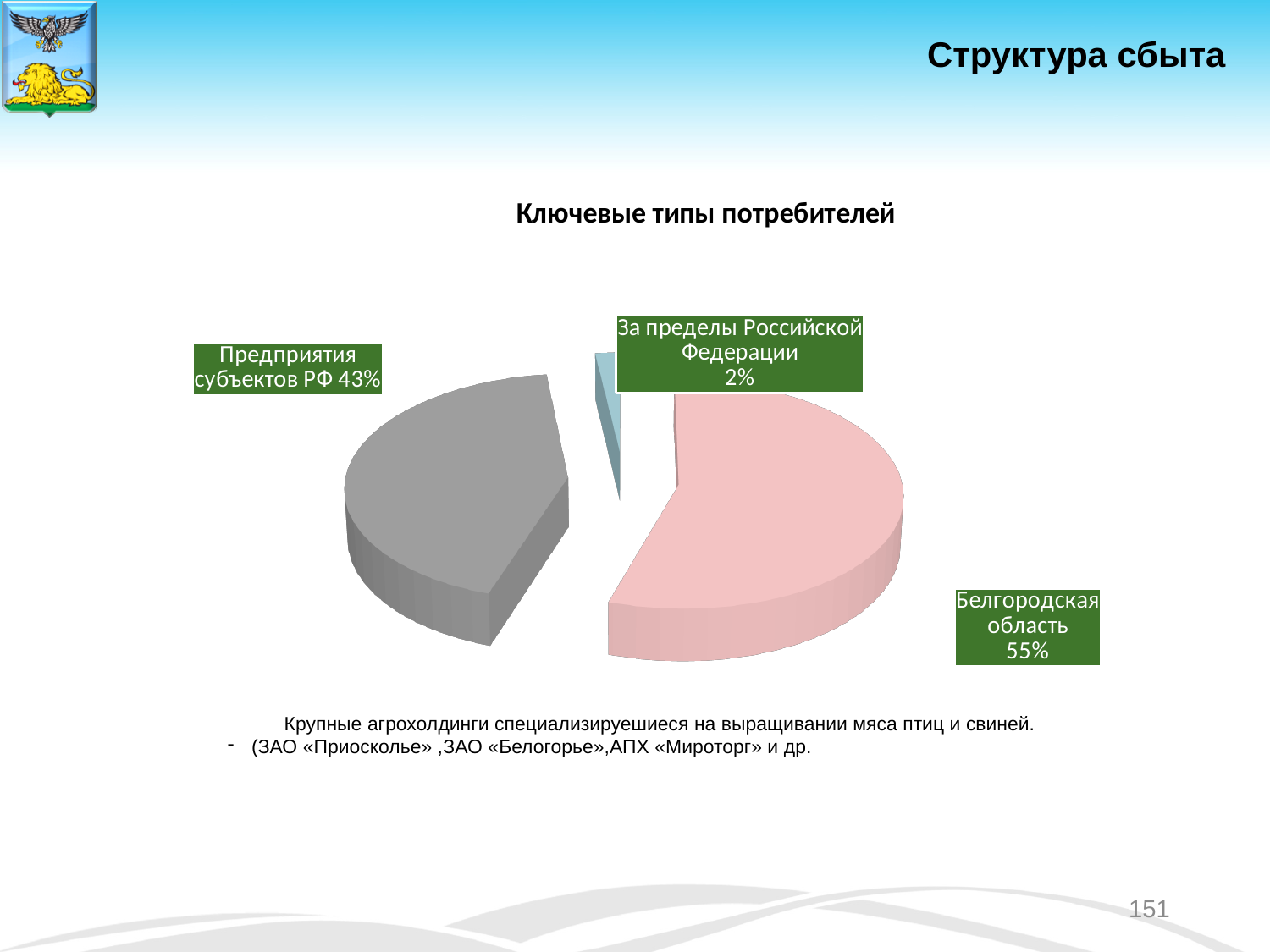
What share of the pie does Белгородская область hold? 55% What share of the pie does За пределы Российской Федерации hold? 2% What is the title of the chart? Ключевые типы потребителей What colour is the slice for Предприятия субъектов РФ? Grey What is the difference between the shares of Белгородская область and Предприятия субъектов РФ? 12% Which category has the largest slice of the pie? Белгородская область What kind of chart is shown on the slide? Pie chart How many categories are shown in the pie chart? 3 What share of the pie does Предприятия субъектов РФ hold? 43% Which is larger: the share of Предприятия субъектов РФ or the share of За пределы Российской Федерации? Предприятия субъектов РФ Which category has the smallest slice of the pie? За пределы Российской Федерации